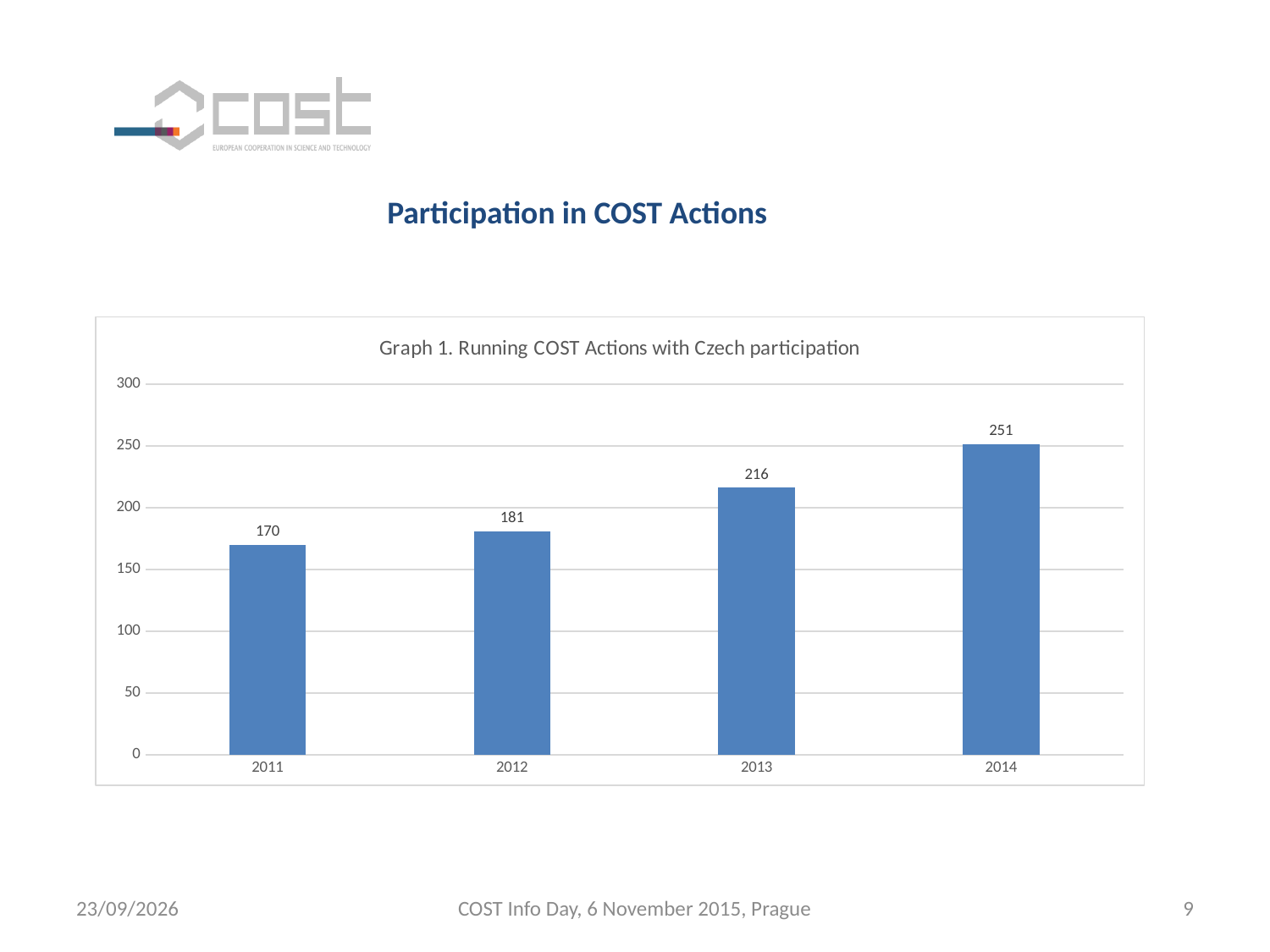
What is the difference between the values for 2014 and 2011? 81 Is the value for 2014 greater or less than 200? greater Do the values rise or fall from 2011 to 2014? rise What is the difference between the values for 2013 and 2012? 35 How many years are shown on the x axis? 4 What kind of chart is shown? bar chart Which is larger, the value for 2012 or the value for 2013? 2013 Which year has the lowest value? 2011 Which year has the highest value? 2014 What is the value for 2013? 216 What is the value for 2011? 170 What is the value for 2014? 251